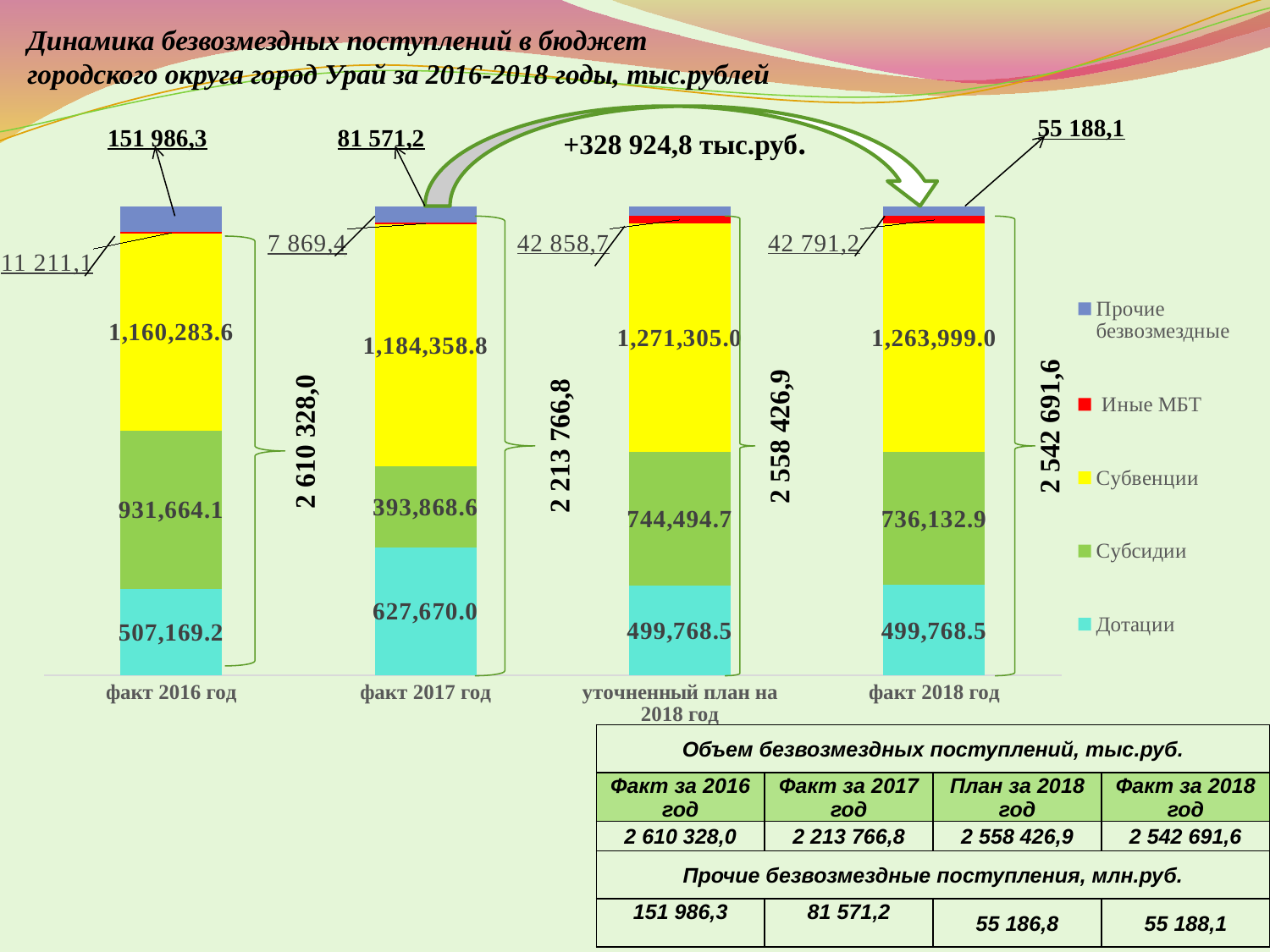
What is the difference between the Субвенции values for уточненный план на 2018 год and факт 2018 год? 7,306.0 How many series does the legend list? 5 Which category has the lowest stacked bar total? факт 2017 год Which is larger, Дотации for факт 2016 год or Дотации for факт 2017 год? факт 2017 год What is the value of Субсидии for уточненный план на 2018 год? 744,494.7 Which category has the highest value for Субсидии? факт 2016 год What is the value of Иные МБТ for факт 2018 год? 42 791,2 What is the total of the stacked bar for факт 2018 год? 2 542 691,6 What is the value of Субвенции for факт 2016 год? 1,160,283.6 How many categories are shown on the x axis? 4 What kind of chart is shown on the slide? stacked bar chart What is the value of Дотации for факт 2017 год? 627,670.0